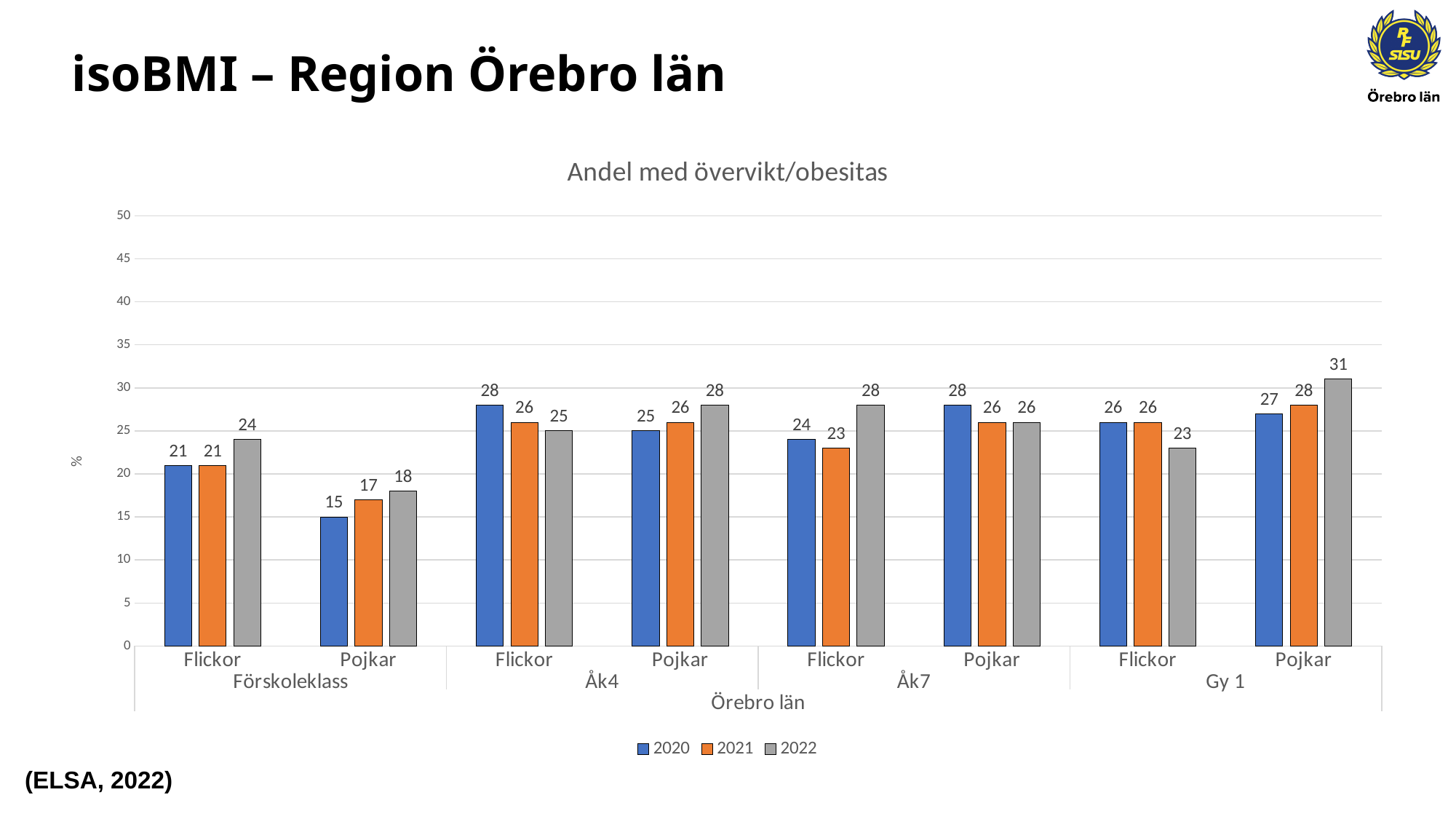
Which colour represents the 2021 series? Orange Which group and year has the highest value in the chart? Pojkar, Gy 1, 2022 What is the 2021 value for Flickor in Åk7? 23 What is the 2022 value for Pojkar in Gy 1? 31 Which group and year has the lowest value in the chart? Pojkar, Förskoleklass, 2020 What kind of chart is shown? Bar chart Which is larger for Flickor in Gy 1: the 2020 value or the 2022 value? 2020 How many series does the legend list? 3 What is the 2020 value for Pojkar in Förskoleklass? 15 What is the title of the chart? Andel med övervikt/obesitas Do the values for Pojkar in Förskoleklass rise or fall from 2020 to 2022? Rise What is the difference between the 2022 and 2020 values for Flickor in Förskoleklass? 3